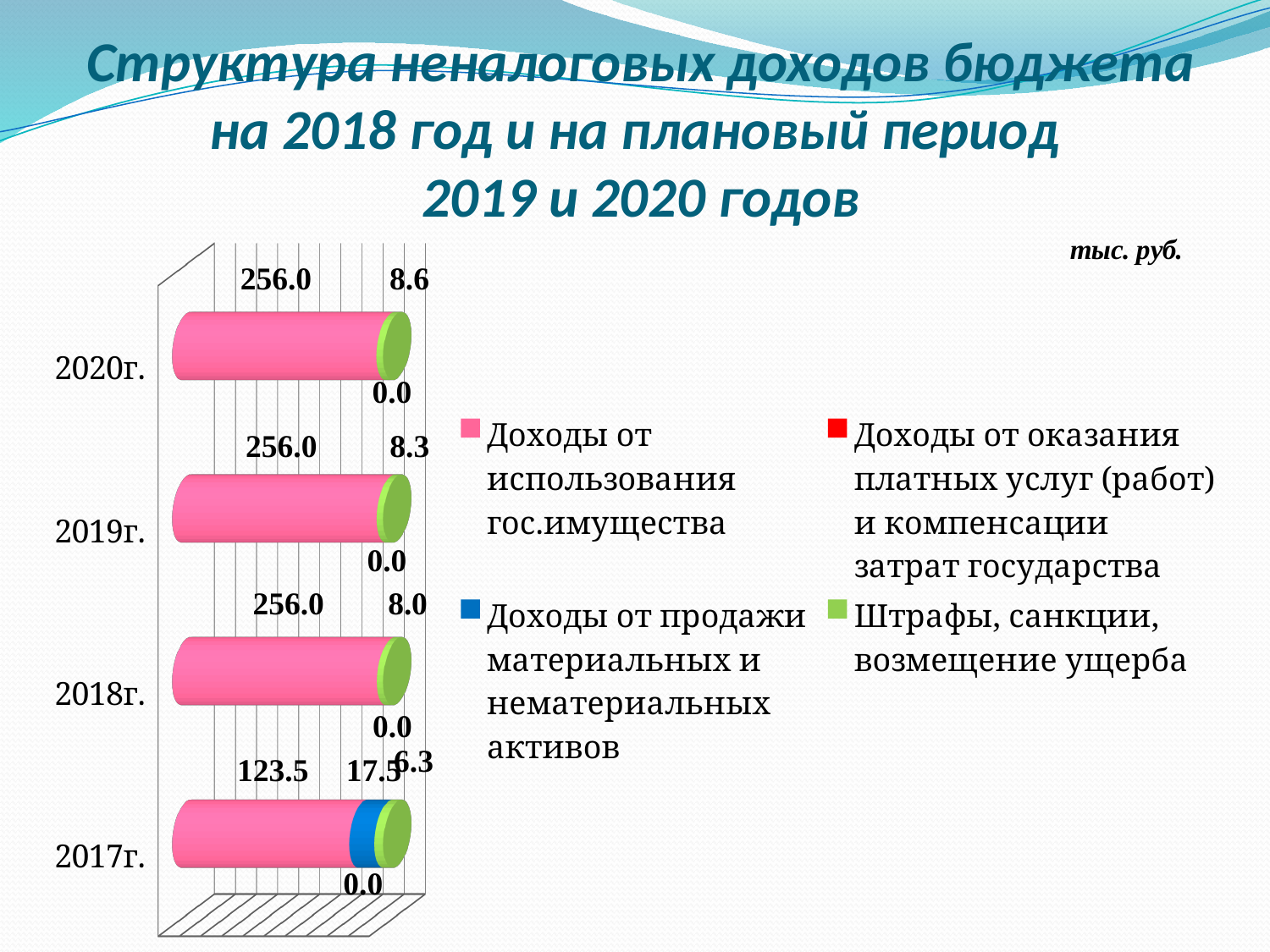
In which year is the value of Штрафы, санкции, возмещение ущерба the lowest? 2017г. In which year is the value of Штрафы, санкции, возмещение ущерба the highest? 2020г. What is the value of Доходы от продажи материальных и нематериальных активов for 2017г.? 17.5 What is the total of the stacked bar for 2017г.? 147.3 Which year has the larger value of Доходы от использования гос.имущества, 2019г. or 2017г.? 2019г. What is the value of Доходы от использования гос.имущества for 2017г.? 123.5 How many years are shown on the chart? 4 How many series does the legend list? 4 What is the value of Доходы от использования гос.имущества for 2020г.? 256.0 What is the difference between Доходы от использования гос.имущества in 2018г. and in 2017г.? 132.5 What kind of chart is shown on the slide? Bar chart What is the value of Штрафы, санкции, возмещение ущерба for 2017г.? 6.3